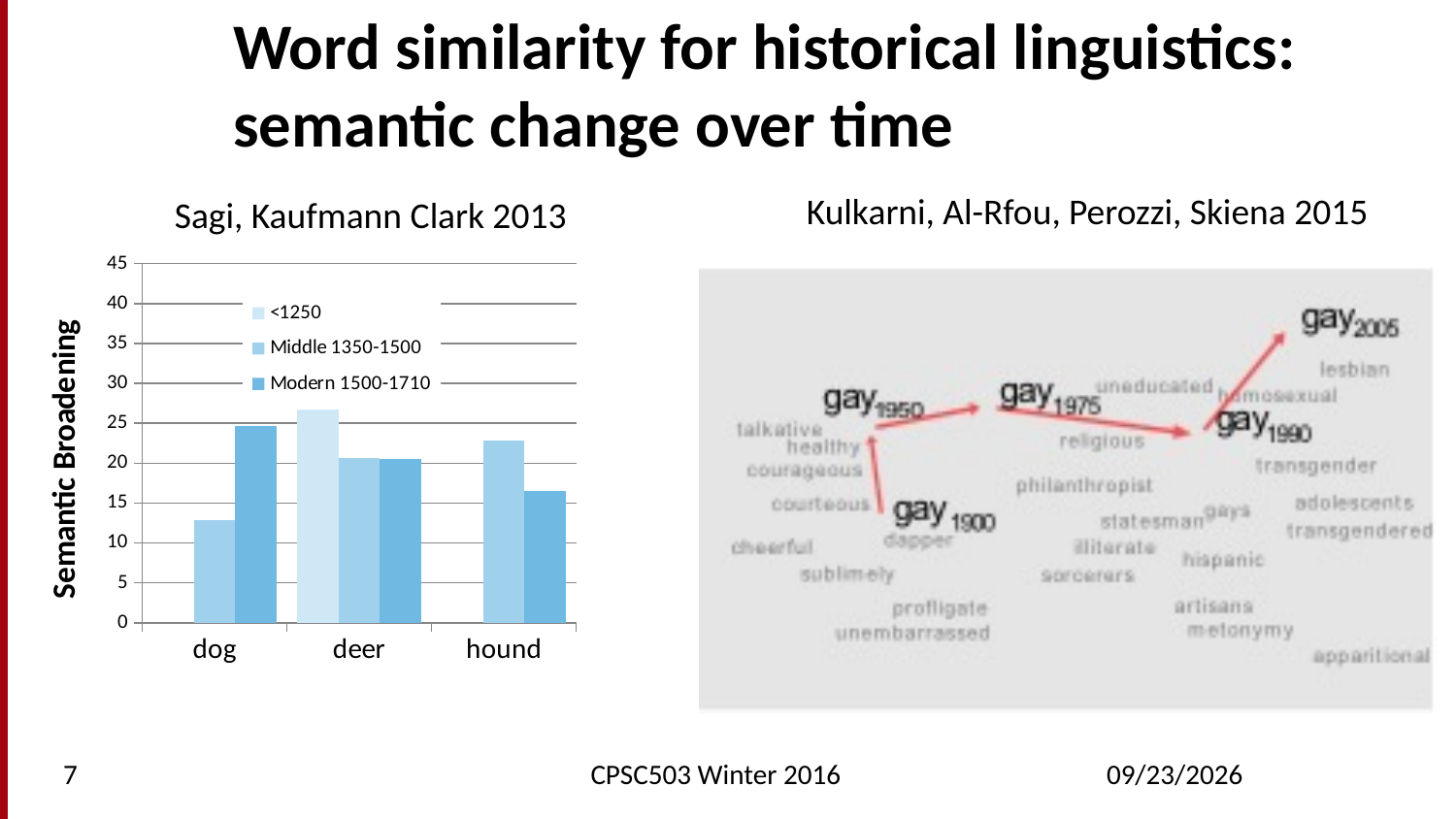
Which series is shown in the darkest blue in the bar chart? Modern 1500-1710 For hound, which is larger: the Middle 1350-1500 value or the Modern 1500-1710 value? Middle 1350-1500 Is the Middle 1350-1500 value for dog greater or less than 15? less How many series does the legend of the bar chart list? 3 How many categories are shown on the x axis of the bar chart? 3 What is the label of the y axis of the bar chart? Semantic Broadening Is the Modern 1500-1710 value for dog greater or less than 20? greater For dog, which is larger: the Middle 1350-1500 value or the Modern 1500-1710 value? Modern 1500-1710 Which category has the highest Modern 1500-1710 value in the bar chart? dog What kind of chart is shown on the left of the slide? bar chart Is the Modern 1500-1710 value for hound greater or less than 20? less